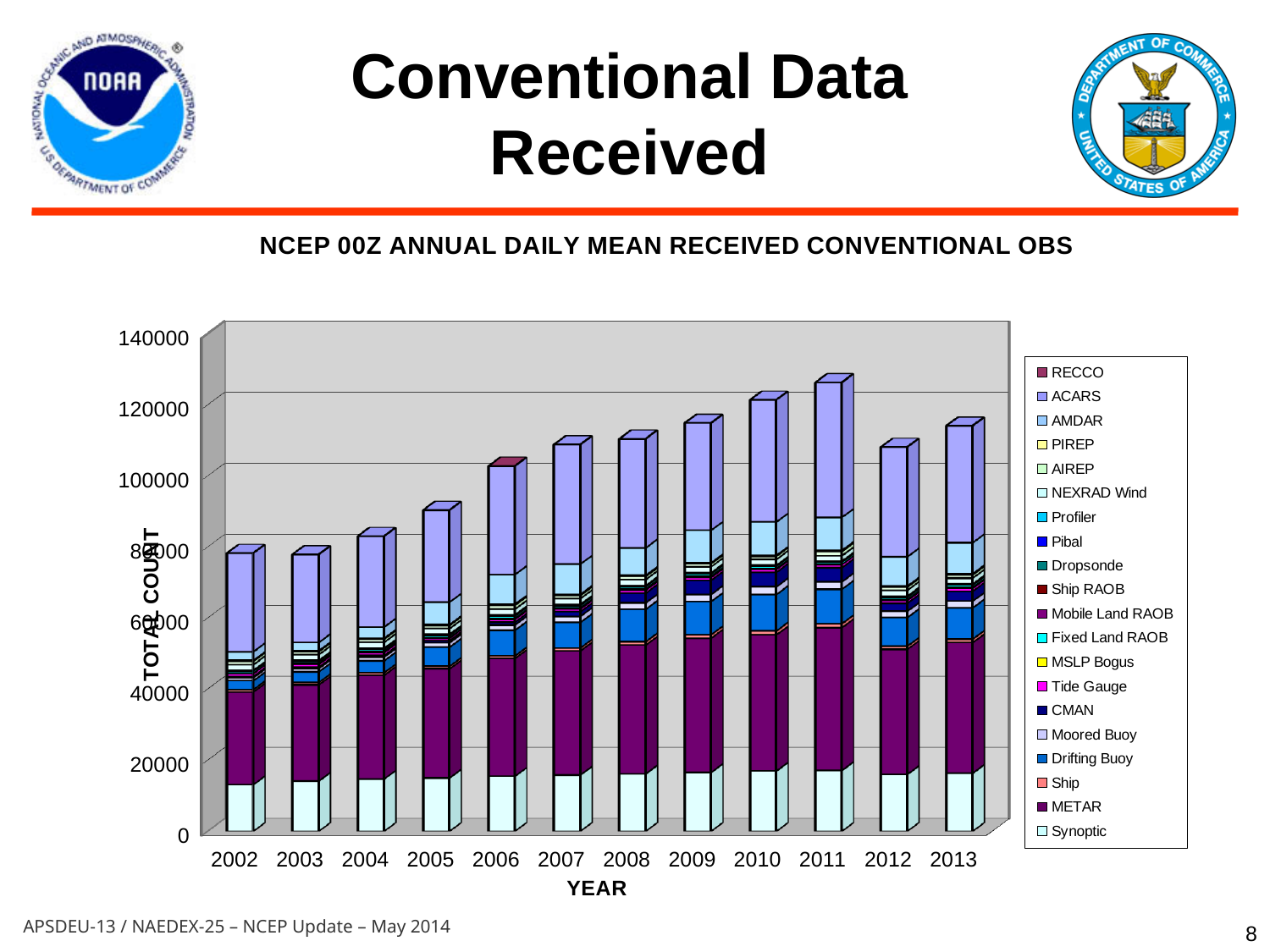
Is the total count for 2011 greater or less than 120000? greater Is the total count for 2012 greater or less than 120000? less Does the total count generally rise or fall from 2002 to 2011? rise What kind of chart is shown on the slide? Stacked bar chart What is the title of the chart? NCEP 00Z ANNUAL DAILY MEAN RECEIVED CONVENTIONAL OBS Which year has the larger total count, 2004 or 2005? 2005 Which year has the larger total count, 2011 or 2012? 2011 Is the total count for 2006 greater or less than 80000? greater Which year has the highest total count in the chart? 2011 How many years are shown along the x axis of the chart? 12 How many series does the chart's legend list? 20